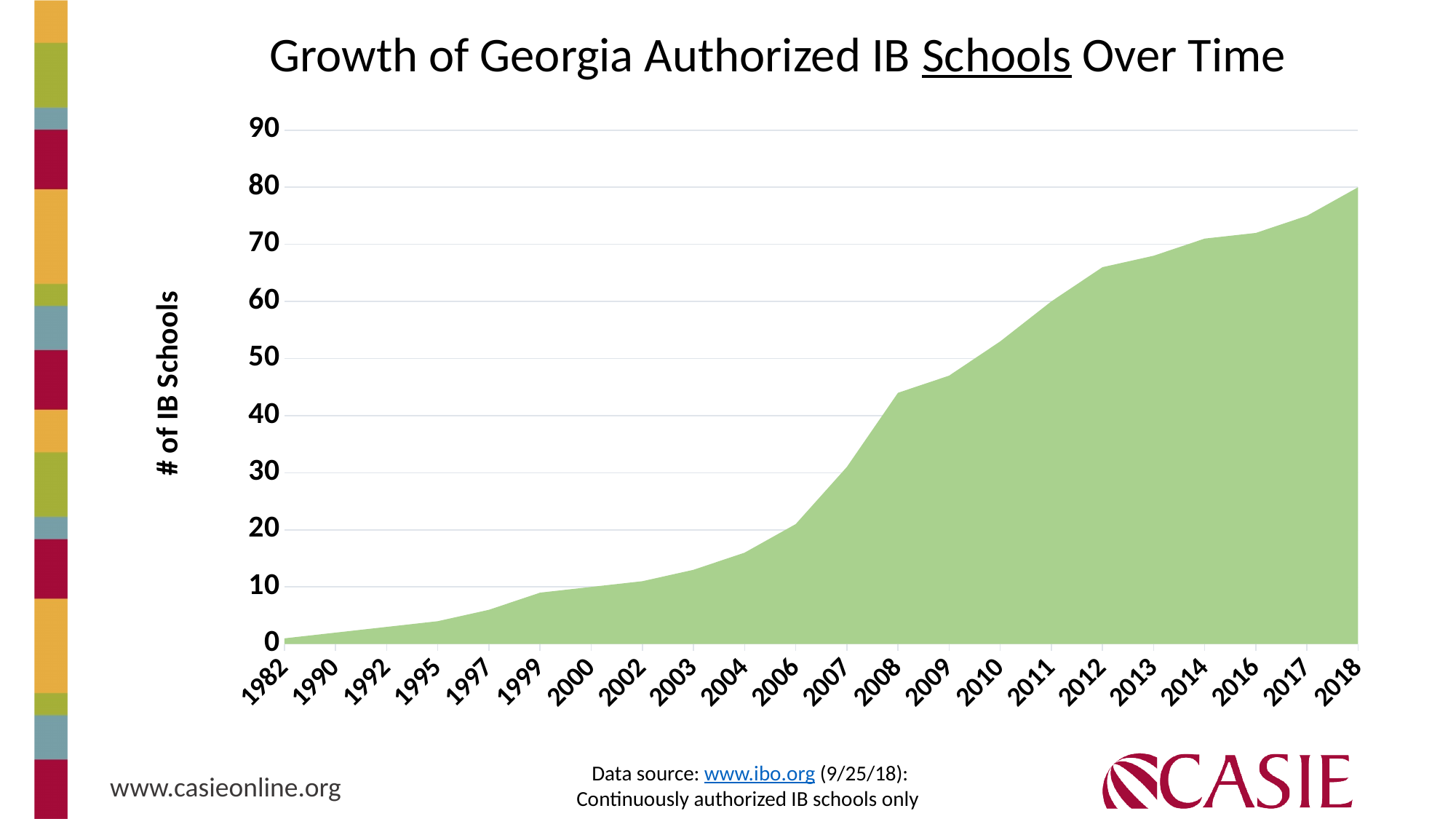
Is the value for 2004 greater or less than 20? less What is the label on the vertical axis of the chart? # of IB Schools Which year has the highest number of IB schools? 2018 Is the value for 2008 greater or less than 40? greater Which year has the lowest number of IB schools? 1982 Do the values rise or fall from 1982 to 2018? Rise How many years are labelled along the x axis of the chart? 22 Which year has more IB schools, 2009 or 2016? 2016 Is the value for 2012 greater or less than 60? greater What is the number of IB schools in 2018? 80 What is the title of the chart? Growth of Georgia Authorized IB Schools Over Time What kind of chart is shown on the slide? Area chart